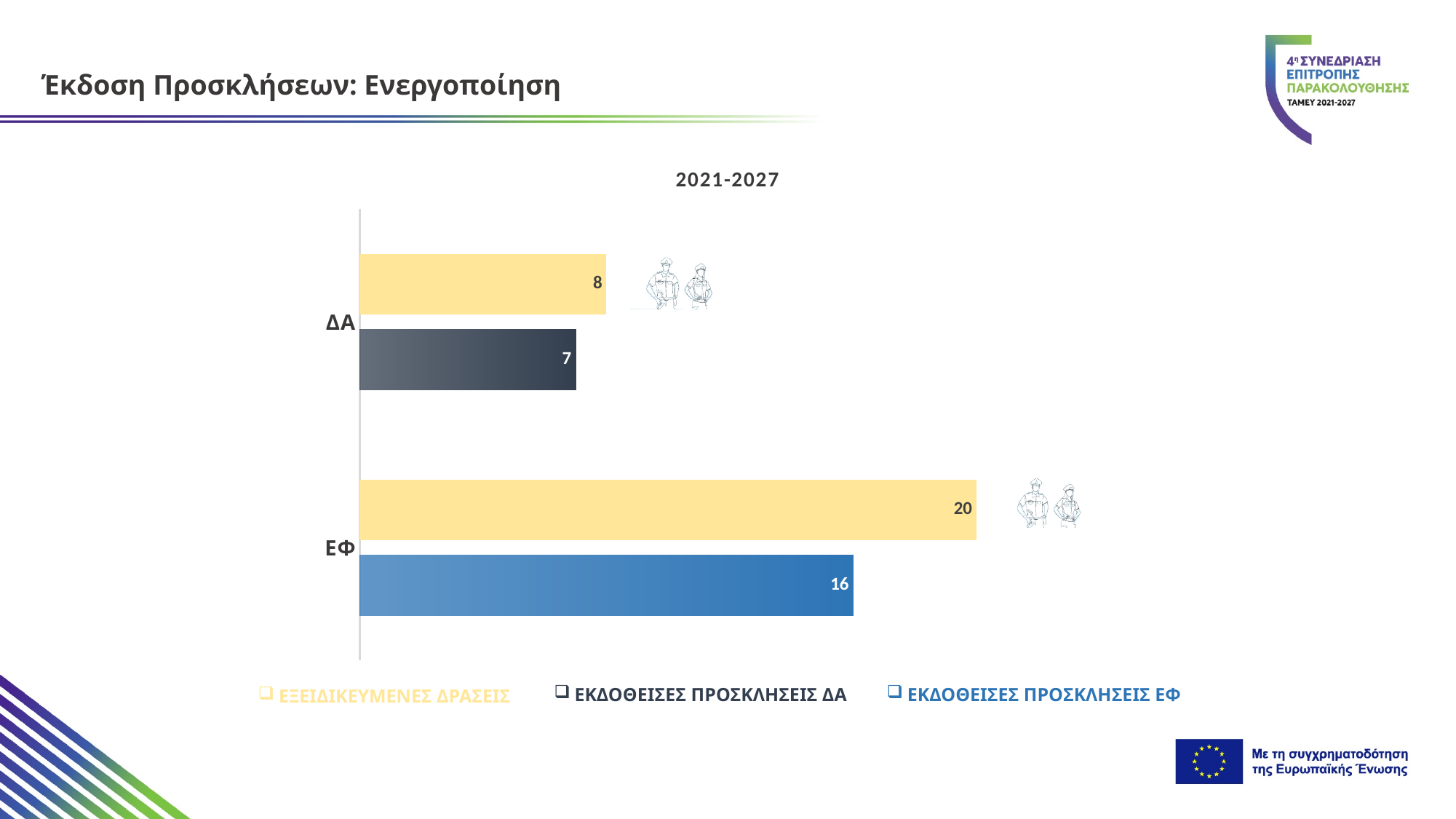
What kind of chart is shown on the slide? Bar chart What is the value of ΕΞΕΙΔΙΚΕΥΜΕΝΕΣ ΔΡΑΣΕΙΣ for ΕΦ? 20 What is the value of ΕΞΕΙΔΙΚΕΥΜΕΝΕΣ ΔΡΑΣΕΙΣ for ΔΑ? 8 Which category has the lowest value for ΕΞΕΙΔΙΚΕΥΜΕΝΕΣ ΔΡΑΣΕΙΣ? ΔΑ What is the value of ΕΚΔΟΘΕΙΣΕΣ ΠΡΟΣΚΛΗΣΕΙΣ ΔΑ for ΔΑ? 7 What is the difference between ΕΞΕΙΔΙΚΕΥΜΕΝΕΣ ΔΡΑΣΕΙΣ and ΕΚΔΟΘΕΙΣΕΣ ΠΡΟΣΚΛΗΣΕΙΣ ΕΦ for ΕΦ? 4 What is the value of ΕΚΔΟΘΕΙΣΕΣ ΠΡΟΣΚΛΗΣΕΙΣ ΕΦ for ΕΦ? 16 How many categories are shown on the chart? 2 Which is larger: ΕΚΔΟΘΕΙΣΕΣ ΠΡΟΣΚΛΗΣΕΙΣ ΕΦ for ΕΦ or ΕΞΕΙΔΙΚΕΥΜΕΝΕΣ ΔΡΑΣΕΙΣ for ΔΑ? ΕΚΔΟΘΕΙΣΕΣ ΠΡΟΣΚΛΗΣΕΙΣ ΕΦ for ΕΦ How many series does the legend list? 3 What is the difference between ΕΞΕΙΔΙΚΕΥΜΕΝΕΣ ΔΡΑΣΕΙΣ and ΕΚΔΟΘΕΙΣΕΣ ΠΡΟΣΚΛΗΣΕΙΣ ΔΑ for ΔΑ? 1 Which category has the highest value for ΕΞΕΙΔΙΚΕΥΜΕΝΕΣ ΔΡΑΣΕΙΣ? ΕΦ